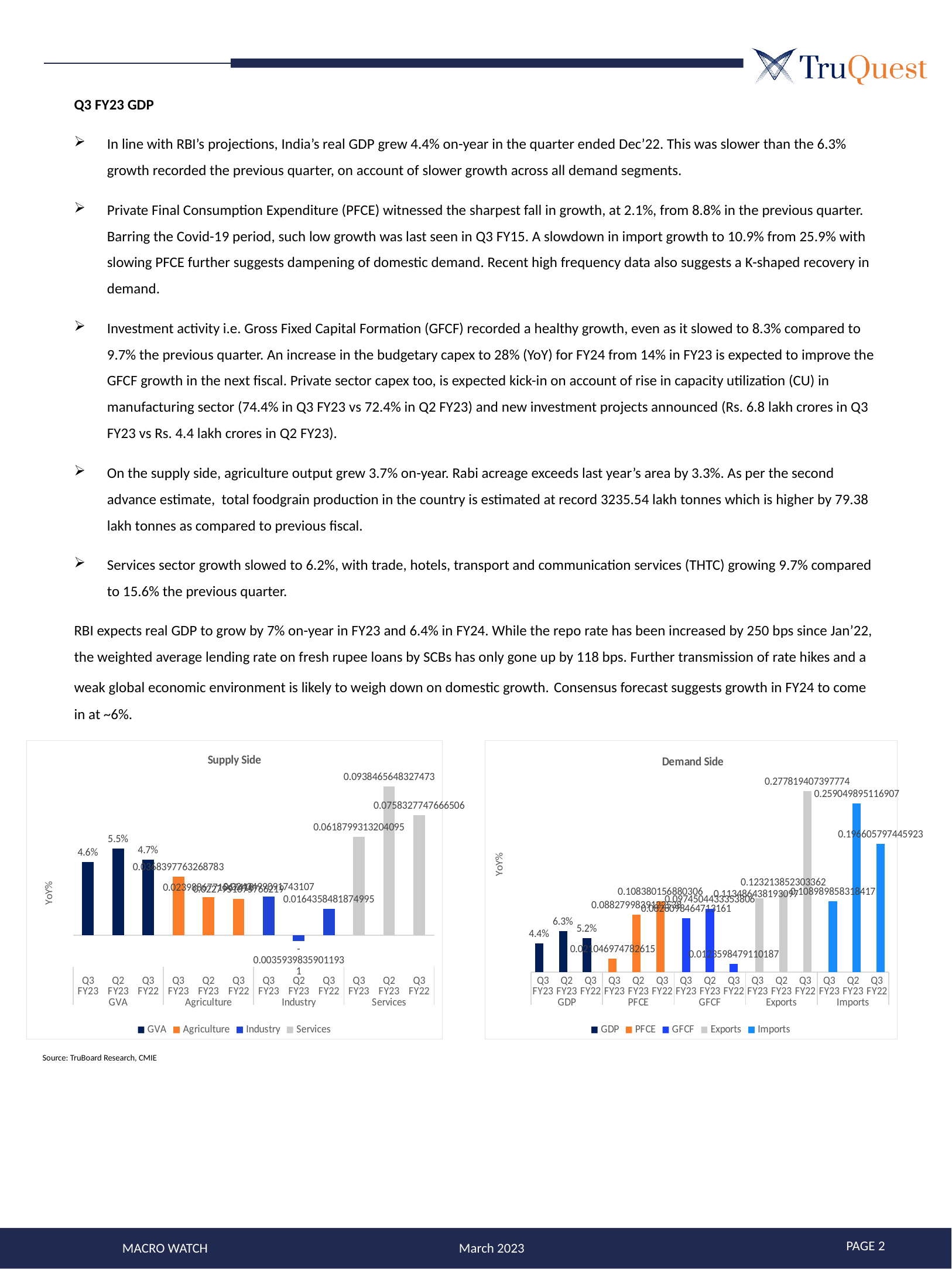
In the Supply Side chart, what is the GVA value for Q3 FY23? 4.6% In the Supply Side chart, which Industry bar is the lowest? Q2 FY23 In the Demand Side chart, is the Exports bar for Q3 FY22 larger or smaller than the Imports bar for Q2 FY23? larger In the Supply Side chart, what is the GVA value for Q2 FY23? 5.5% In the Supply Side chart, which of the three GVA bars is the highest? Q2 FY23 In the Supply Side chart, what is the Services value for Q2 FY23? 0.0938465648327473 How many series does the legend of the Demand Side chart list? 5 In the Demand Side chart, what is the Imports value for Q3 FY22? 0.196605797445923 In the Demand Side chart, which of the three GDP bars is the highest? Q2 FY23 What kind of chart is the Supply Side chart? bar chart In the Demand Side chart, what is the GDP value for Q3 FY23? 4.4% How many series does the legend of the Supply Side chart list? 4